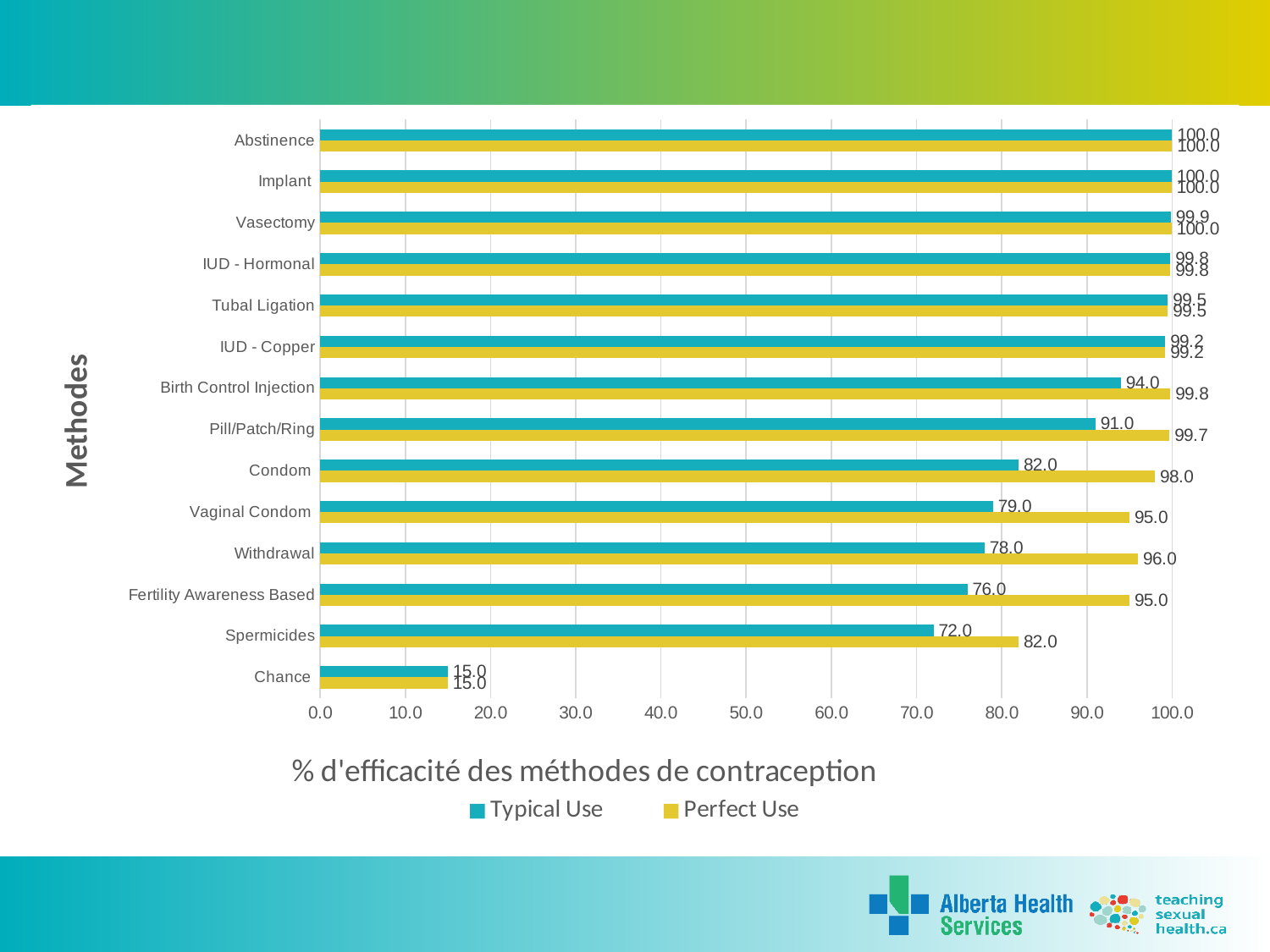
What is the Perfect Use value for Spermicides? 82.0 What is the Typical Use value for Condom? 82.0 What is the Typical Use value for Birth Control Injection? 94.0 Which method has the lowest Typical Use value? Chance How many series does the legend list? 2 What is the difference between the Perfect Use and Typical Use values for Fertility Awareness Based? 19.0 What is the difference between the Perfect Use and Typical Use values for Pill/Patch/Ring? 8.7 What is the title shown below the x axis of the chart? % d'efficacité des méthodes de contraception How many contraception methods are listed on the chart? 14 What kind of chart is shown on the slide? bar chart Which is larger, the Typical Use value for Vaginal Condom or the Typical Use value for Spermicides? Vaginal Condom What is the Perfect Use value for Withdrawal? 96.0